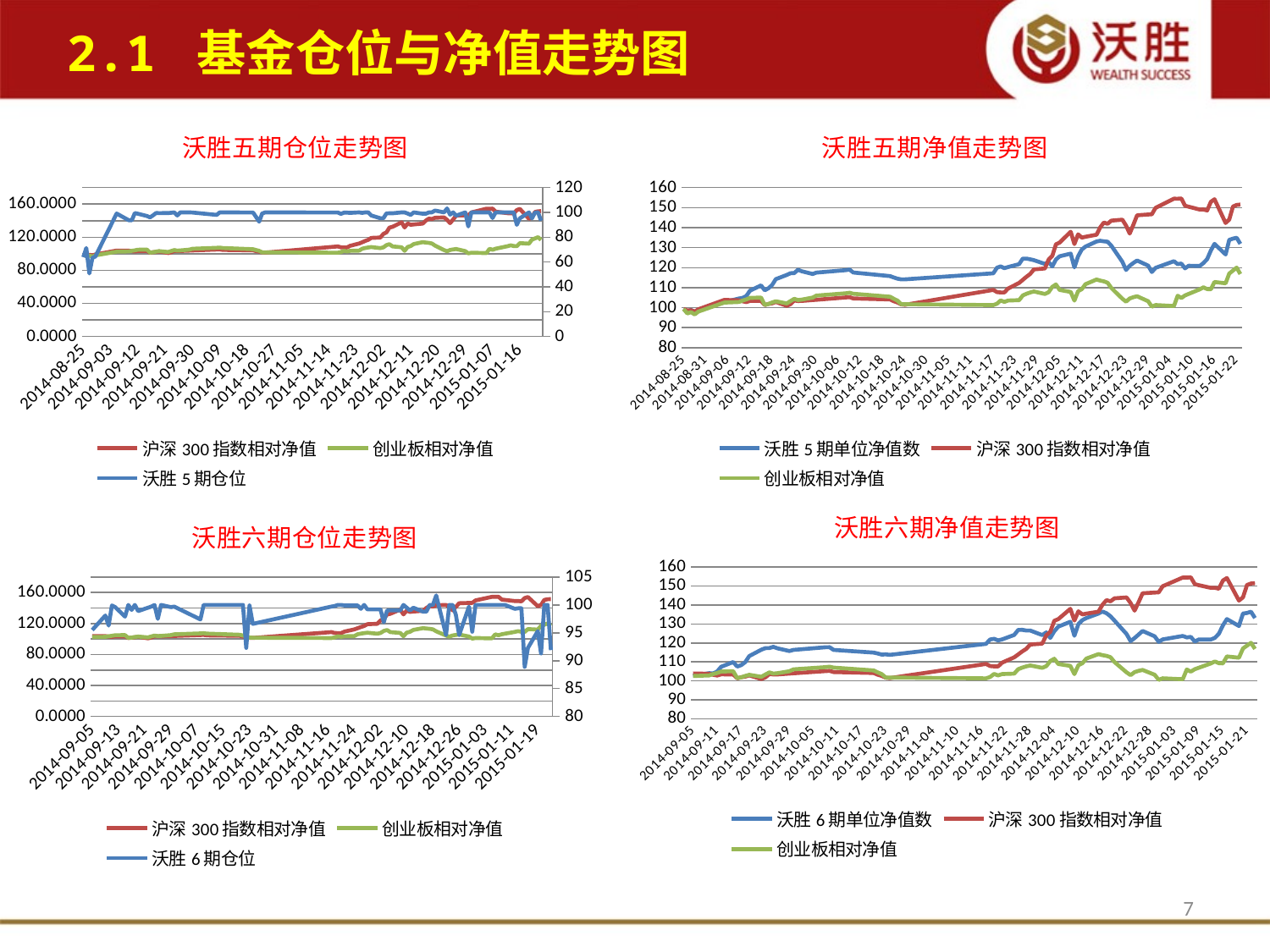
What is the title of the chart in the bottom-left of the slide? 沃胜六期仓位走势图 How many series does the legend of the 沃胜五期仓位走势图 chart list? 3 In the 沃胜五期净值走势图 chart, is the final value of 沃胜 5 期单位净值数 greater or less than 120? greater In the 沃胜六期净值走势图 chart, is the final value of 创业板相对净值 greater or less than 110? greater In the 沃胜五期净值走势图 chart, which series ends at the highest value at the right end of the x axis? 沪深 300 指数相对净值 In the 沃胜六期净值走势图 chart, is the final value of 沪深 300 指数相对净值 greater or less than 140? greater What kind of chart is the 沃胜五期仓位走势图 chart? line chart In the 沃胜五期净值走势图 chart, does the 沪深 300 指数相对净值 line generally rise or fall from left to right? rise In the 沃胜五期净值走势图 chart, how many series does the legend list? 3 In the 沃胜六期净值走势图 chart, at the right end of the x axis, which is larger: 沪深 300 指数相对净值 or 创业板相对净值? 沪深 300 指数相对净值 In the 沃胜六期仓位走势图 chart, which series is drawn in blue? 沃胜 6 期仓位